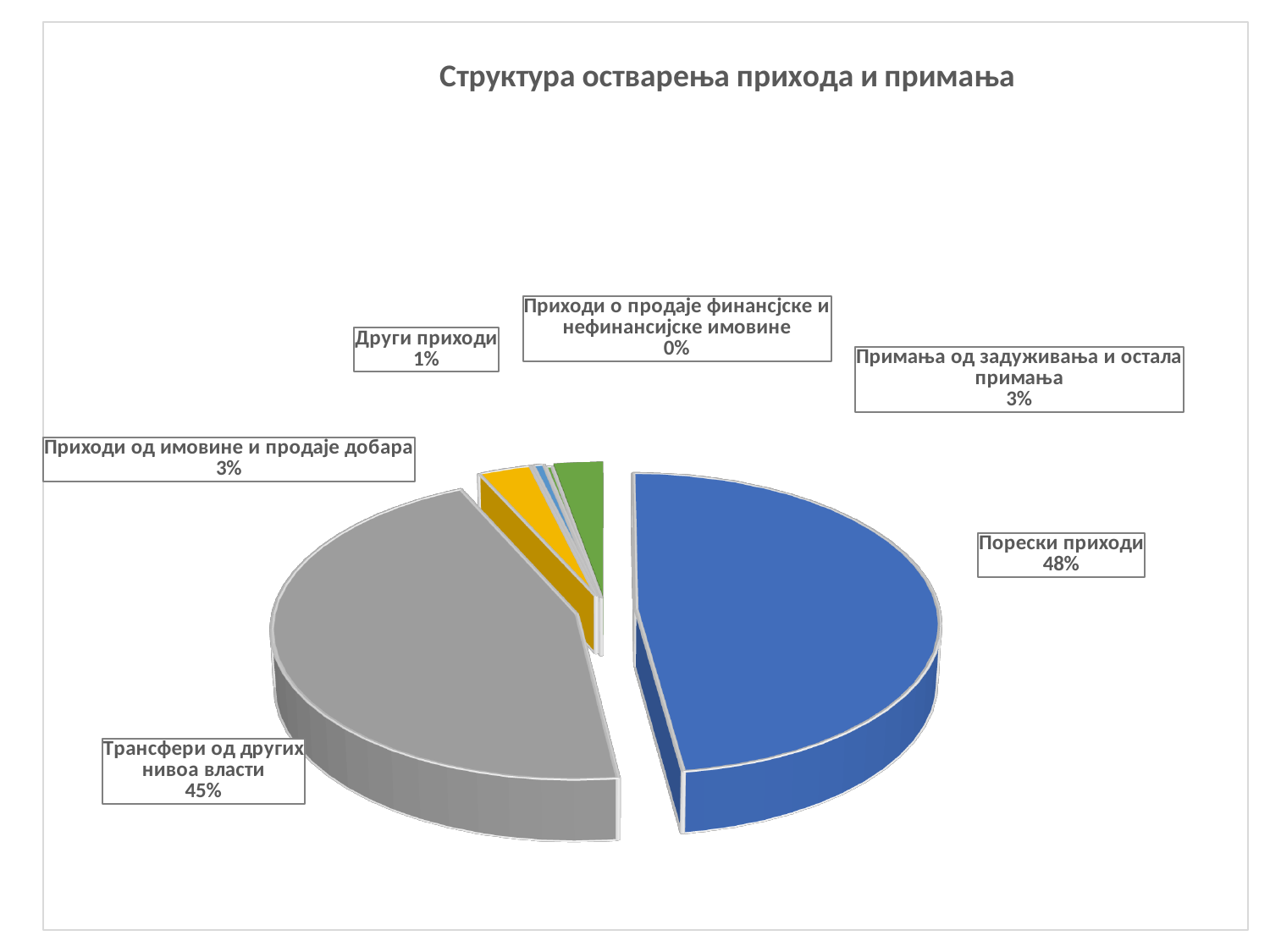
Which category has the smallest share of the pie? Приходи о продаје финансјске и нефинансијске имовине What share of the pie is Приходи од имовине и продаје добара? 3% What is the title of the chart? Структура остварења прихода и примања How many categories (slices) does the pie chart have? 6 What share of the pie is Трансфери од других нивоа власти? 45% What share of the pie is Приходи о продаје финансјске и нефинансијске имовине? 0% Which category has the largest share of the pie? Порески приходи What type of chart is shown on the slide? Pie chart What is the difference in percentage points between Порески приходи and Трансфери од других нивоа власти? 3%